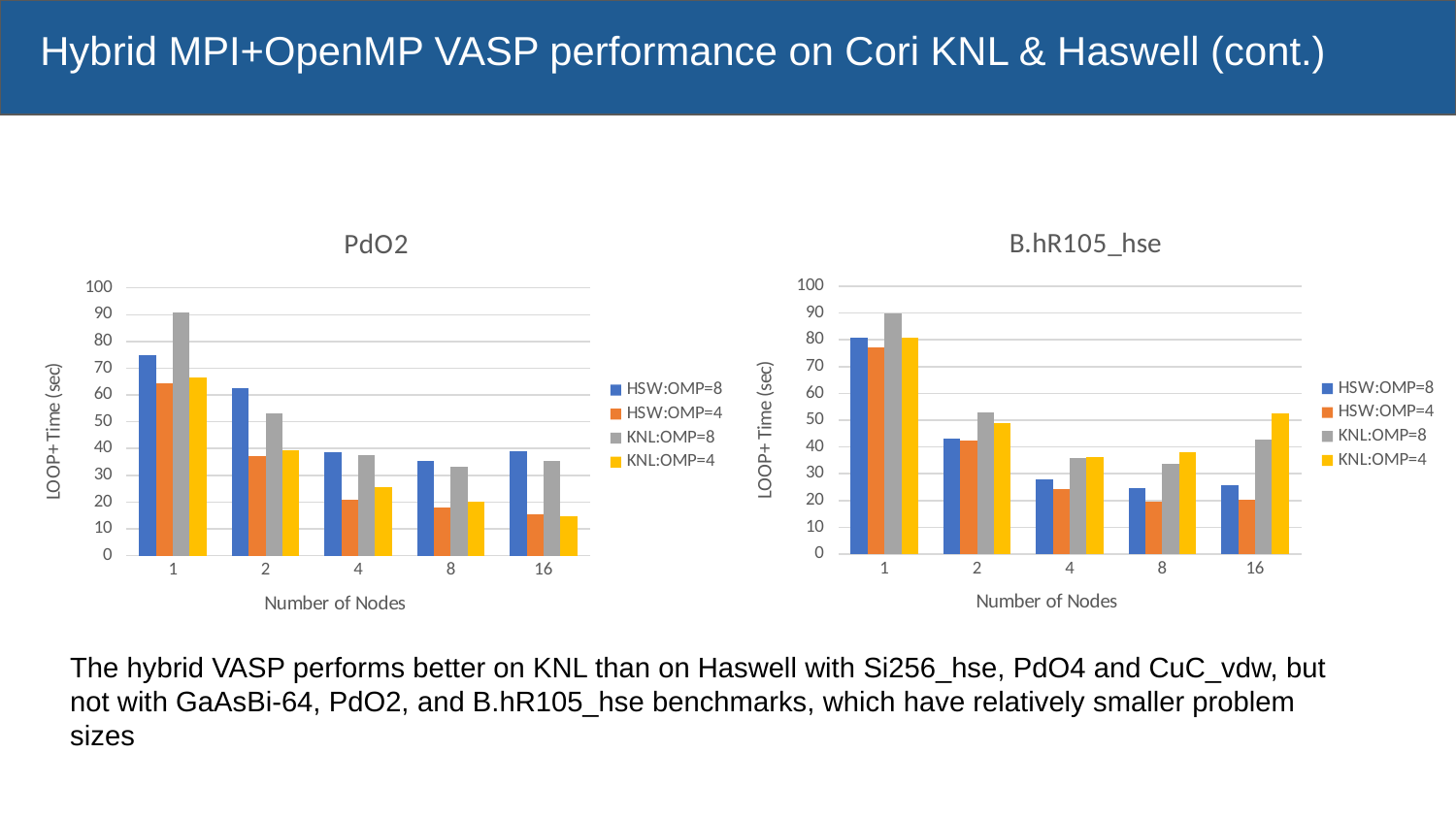
What is the x-axis title of the B.hR105_hse chart? Number of Nodes What is the y-axis label of the B.hR105_hse chart? LOOP+ Time (sec) How many node counts are shown on the x axis of the PdO2 chart? 5 In the PdO2 chart, is the value for KNL:OMP=8 at 1 node greater or less than 80? greater In the PdO2 chart, which series has the highest LOOP+ Time at 1 node? KNL:OMP=8 In the B.hR105_hse chart, is the value for KNL:OMP=4 at 16 nodes greater or less than 40? greater In the B.hR105_hse chart, at 16 nodes, which is larger: KNL:OMP=4 or HSW:OMP=4? KNL:OMP=4 How many series does the legend of the PdO2 chart list? 4 In the PdO2 chart, is the value for HSW:OMP=8 at 4 nodes greater or less than 30? greater In the PdO2 chart, does the HSW:OMP=4 series rise or fall from 1 node to 16 nodes? fall What kind of chart is the PdO2 chart? bar chart In the B.hR105_hse chart, which series has the lowest LOOP+ Time at 8 nodes? HSW:OMP=4